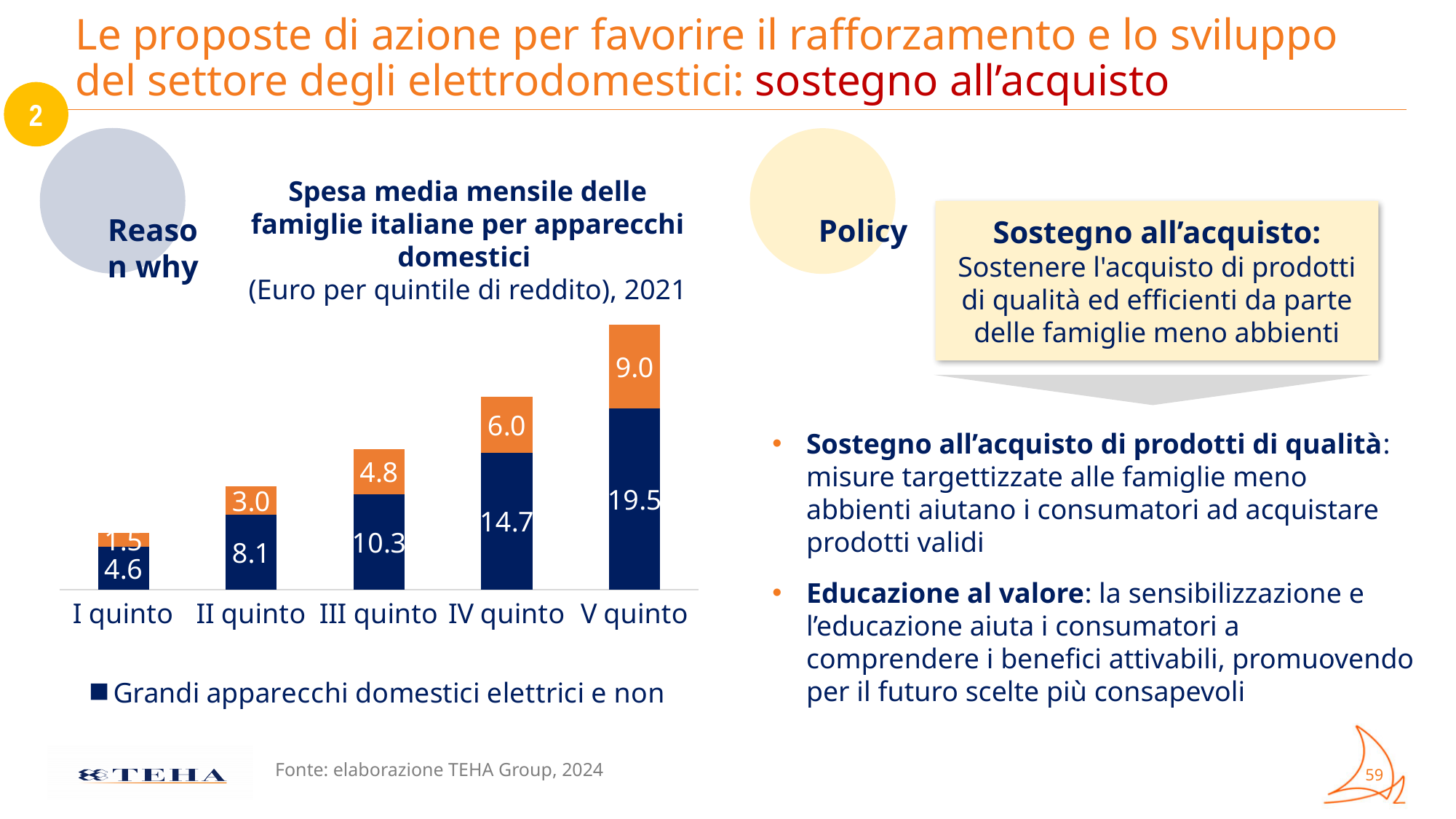
What is the total of the stacked bar for IV quinto? 20.7 What is the value of the 'Grandi apparecchi domestici elettrici e non' (dark blue) segment for I quinto? 4.6 What is the value of the orange segment for V quinto? 9.0 Which quintile has the lowest value for the orange segment? I quinto Which quintile has the highest value for the dark blue 'Grandi apparecchi domestici elettrici e non' segment? V quinto Do the values of the dark blue segment rise or fall from I quinto to V quinto? rise What is the value of the orange segment for II quinto? 3.0 What is the difference between the dark blue segment values for V quinto and I quinto? 14.9 What is the value of the dark blue segment for III quinto? 10.3 What kind of chart is shown on the slide? stacked bar chart Which year does the chart's data refer to, according to its title? 2021 How many income quintiles (categories) are shown on the x axis of the chart? 5